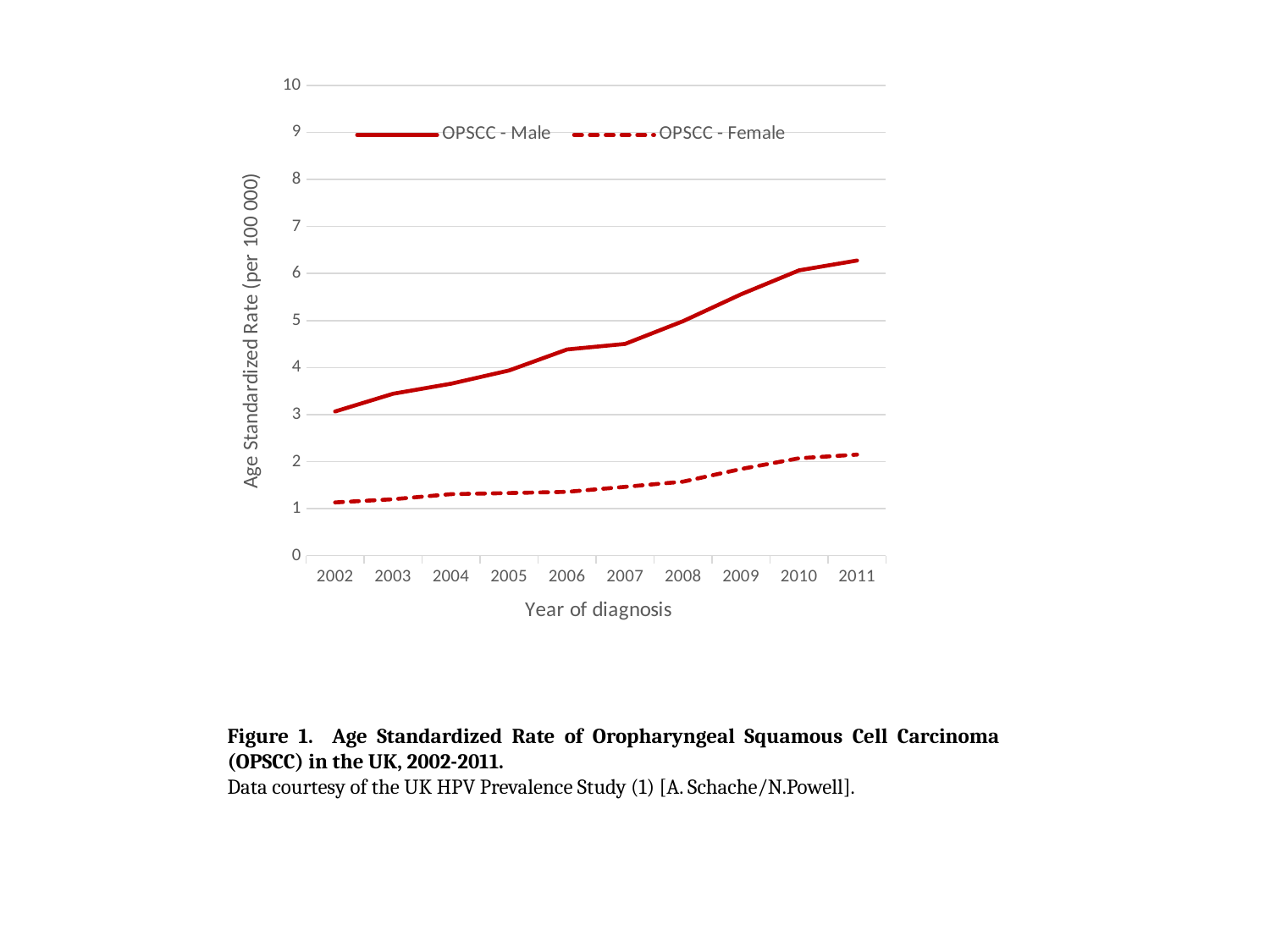
Does the OPSCC - Male rate rise or fall from 2002 to 2011? rise In which year is the OPSCC - Male rate highest? 2011 In which year is the OPSCC - Female rate lowest? 2002 What kind of chart is shown on the slide? line chart In which year is the OPSCC - Male rate lowest? 2002 How many series does the legend list? 2 Is the OPSCC - Female value for 2008 greater or less than 2? less Does the OPSCC - Female rate rise or fall from 2002 to 2011? rise How many years are shown along the x axis? 10 What is the label of the y axis? Age Standardized Rate (per 100 000) Is the OPSCC - Male value for 2011 greater or less than 6? greater In 2011, which series has the larger value, OPSCC - Male or OPSCC - Female? OPSCC - Male